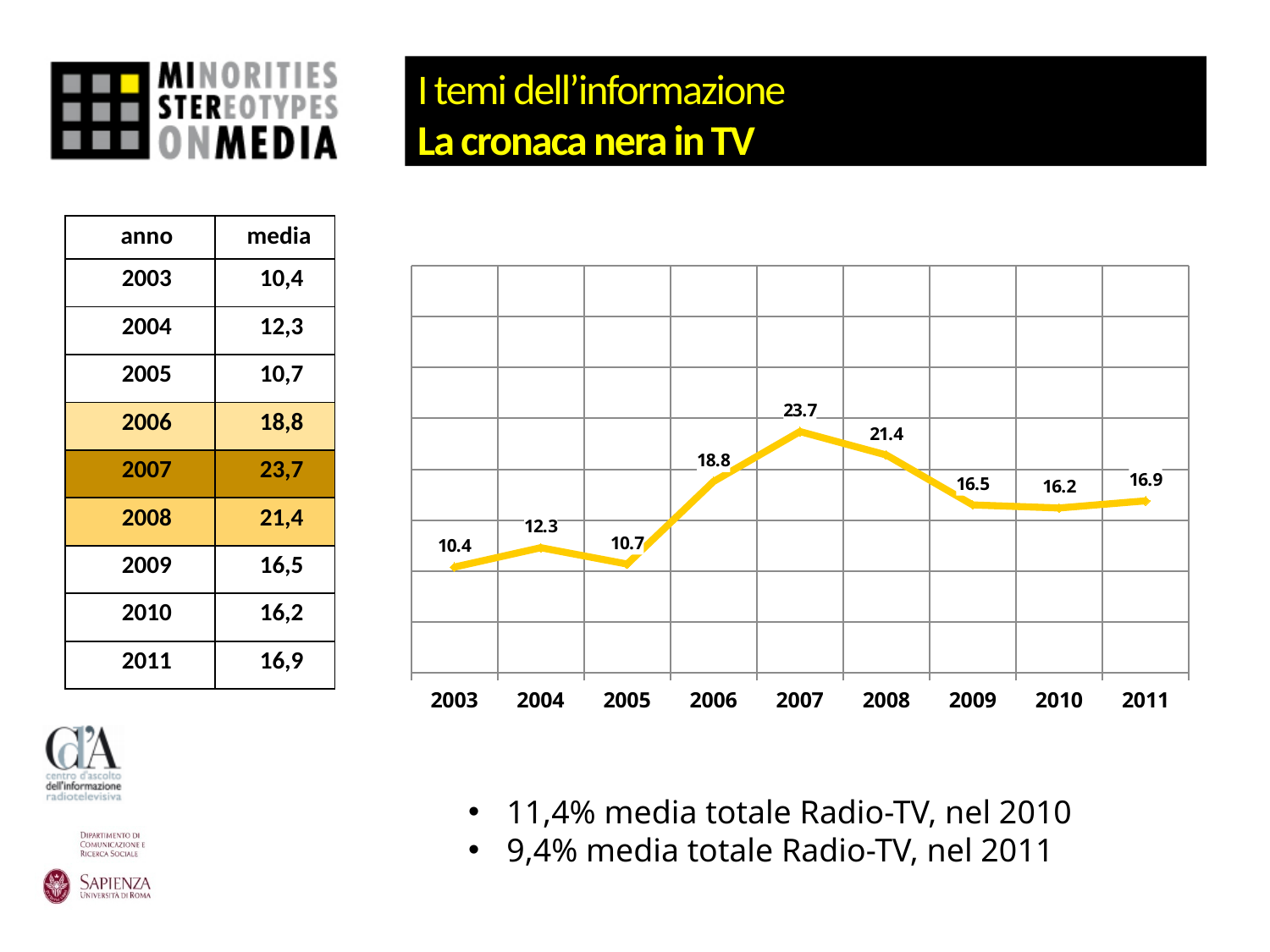
What type of chart is shown on the slide? line chart What colour is the line in the chart? yellow What is the difference between the values for 2006 and 2005 in the line chart? 8.1 What is the value for 2007 in the line chart? 23.7 What is the value for 2003 in the line chart? 10.4 Which year has the highest value in the line chart? 2007 Which year has the lowest value in the line chart? 2003 Which year has the larger value in the line chart, 2004 or 2009? 2009 What is the difference between the values for 2007 and 2008 in the line chart? 2.3 Does the line rise or fall between 2007 and 2010? fall What is the value for 2011 in the line chart? 16.9 How many years are plotted on the x axis of the line chart? 9